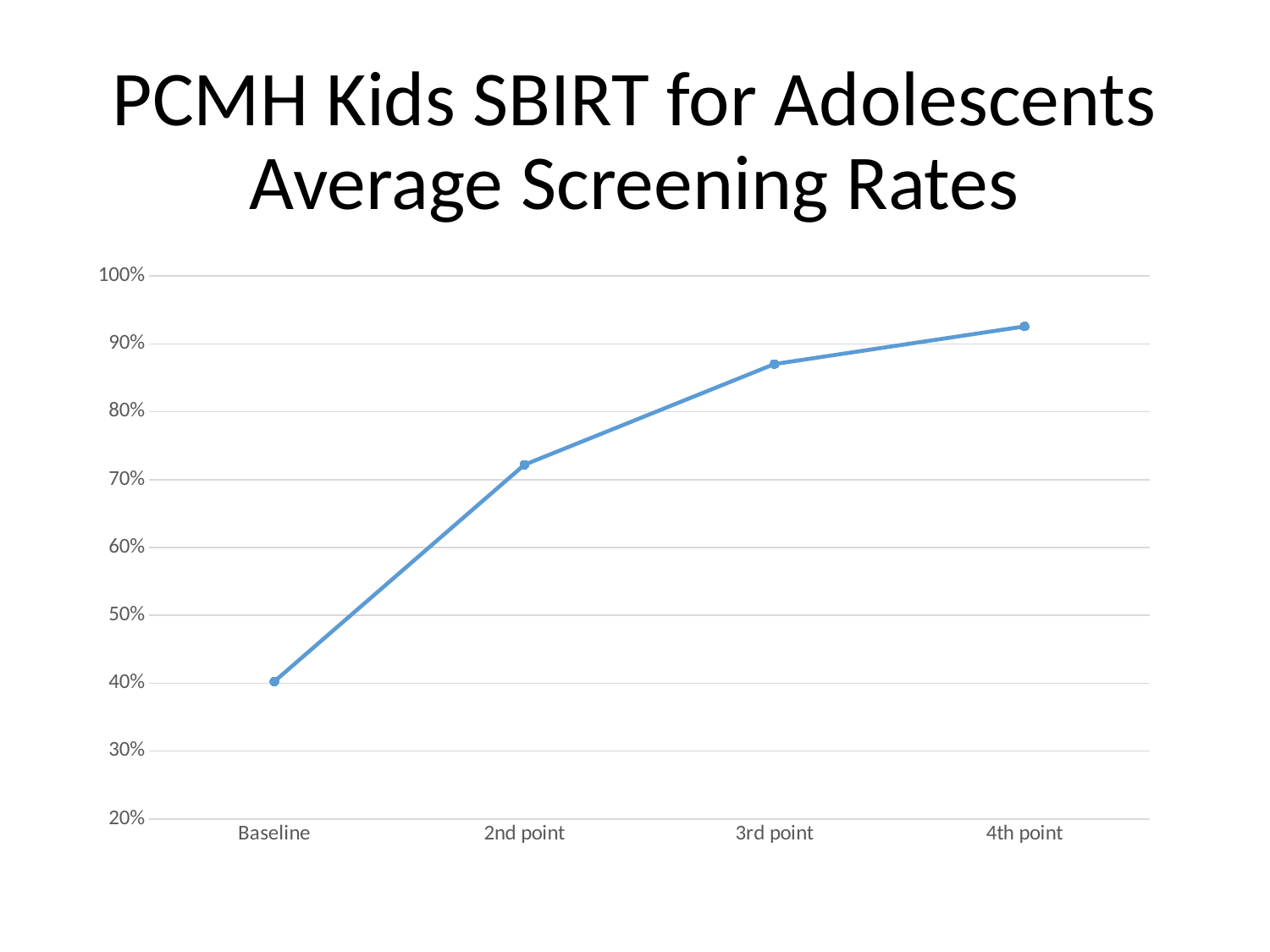
Which point has the highest average screening rate? 4th point Do the screening rates rise or fall from Baseline to the 4th point? rise Is the value for 4th point greater or less than 90%? greater Is the value for 2nd point greater or less than 80%? less What kind of chart is shown on the slide? line chart Which point has the lowest average screening rate? Baseline How many data points are plotted on the line? 4 Is the value for Baseline greater or less than 50%? less What is the title of the slide? PCMH Kids SBIRT for Adolescents Average Screening Rates Which has the larger screening rate, 2nd point or 3rd point? 3rd point